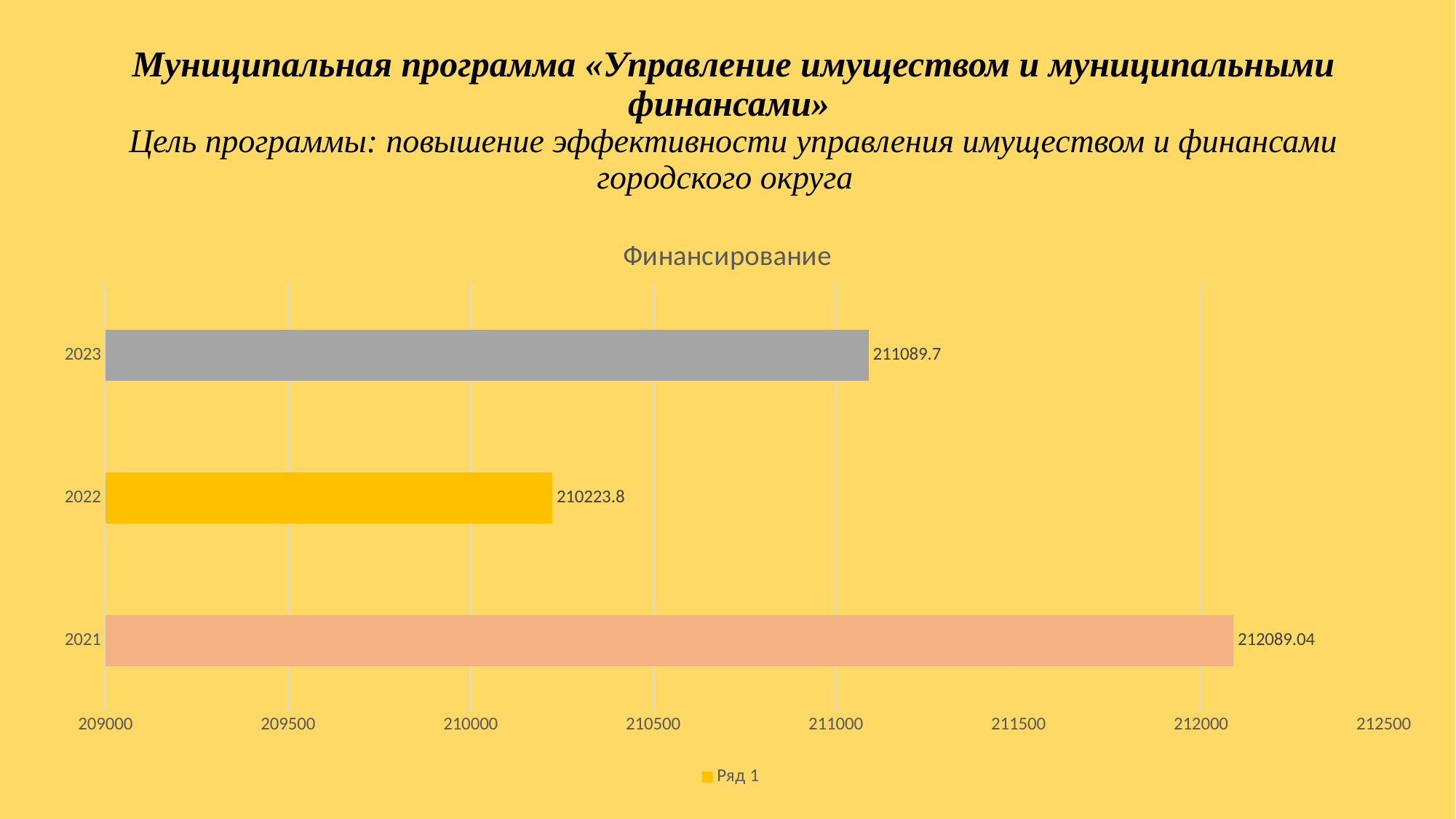
What type of chart is the Финансирование chart? Bar chart What is the value for 2021 in the Финансирование chart? 212089.04 What series name is listed in the legend of the Финансирование chart? Ряд 1 Which is larger in the Финансирование chart, the value for 2023 or the value for 2022? 2023 What is the value for 2023 in the Финансирование chart? 211089.7 What is the difference between the values for 2023 and 2022 in the Финансирование chart? 865.9 Which year has the lowest value in the Финансирование chart? 2022 How many years are shown in the Финансирование chart? 3 Which year has the highest value in the Финансирование chart? 2021 What is the value for 2022 in the Финансирование chart? 210223.8 Is the value for 2021 in the Финансирование chart greater or less than 212000? greater What is the difference between the values for 2021 and 2022 in the Финансирование chart? 1865.24